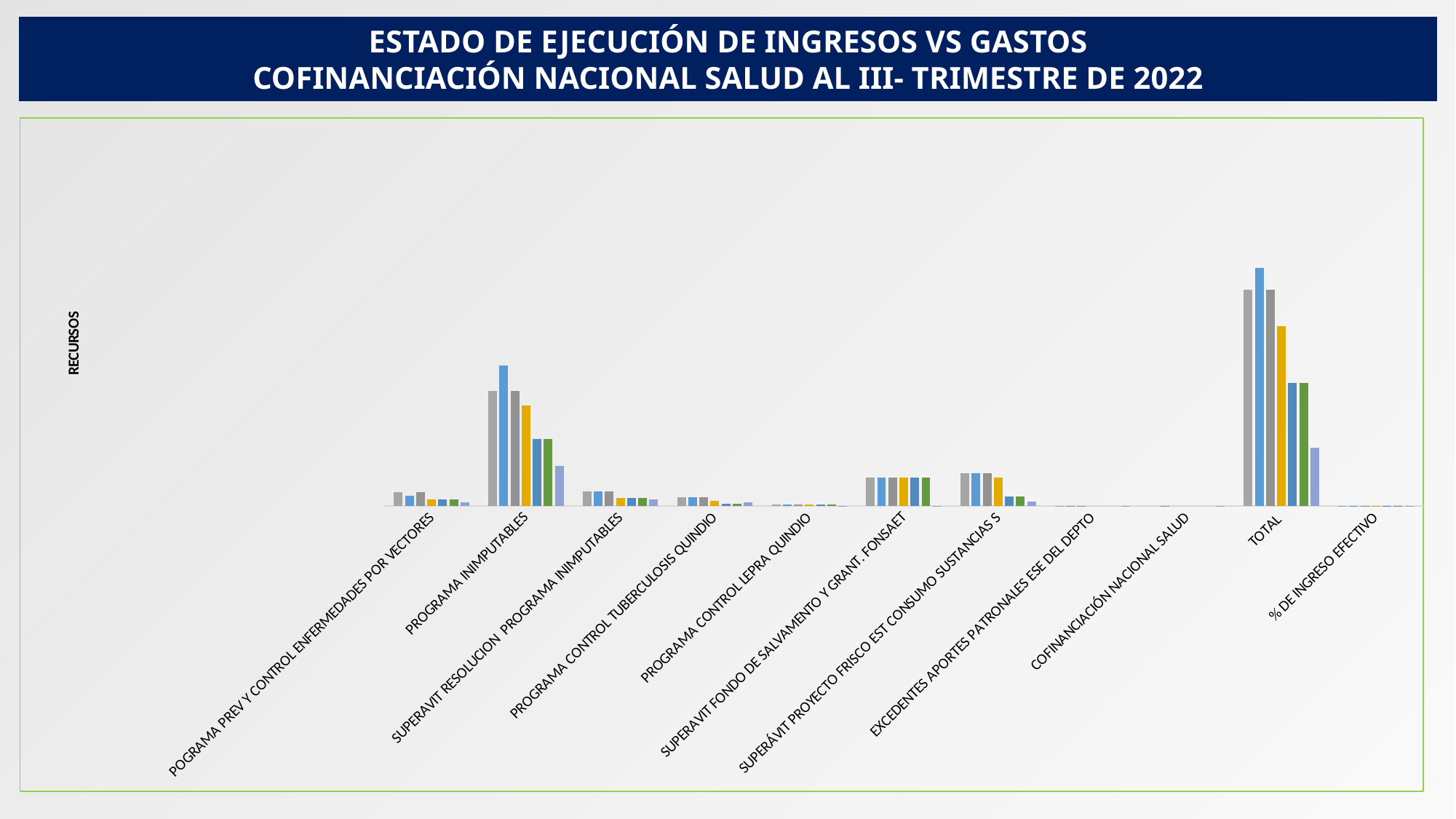
Which category has the tallest bars in the chart? TOTAL How many bars are plotted for the TOTAL category? 7 How many categories are shown along the x axis of the chart? 11 Which category has taller bars: TOTAL or % DE INGRESO EFECTIVO? TOTAL Which category has taller bars: SUPERAVIT FONDO DE SALVAMENTO Y GRANT. FONSAET or PROGRAMA CONTROL LEPRA QUINDIO? SUPERAVIT FONDO DE SALVAMENTO Y GRANT. FONSAET What is the title shown above the chart? ESTADO DE EJECUCIÓN DE INGRESOS VS GASTOS COFINANCIACIÓN NACIONAL SALUD AL III- TRIMESTRE DE 2022 What kind of chart is shown on the slide? bar chart What is the label on the vertical axis of the chart? RECURSOS Which category has taller bars: PROGRAMA INIMPUTABLES or SUPERAVIT RESOLUCION PROGRAMA INIMPUTABLES? PROGRAMA INIMPUTABLES Excluding TOTAL, which category has the tallest bars? PROGRAMA INIMPUTABLES